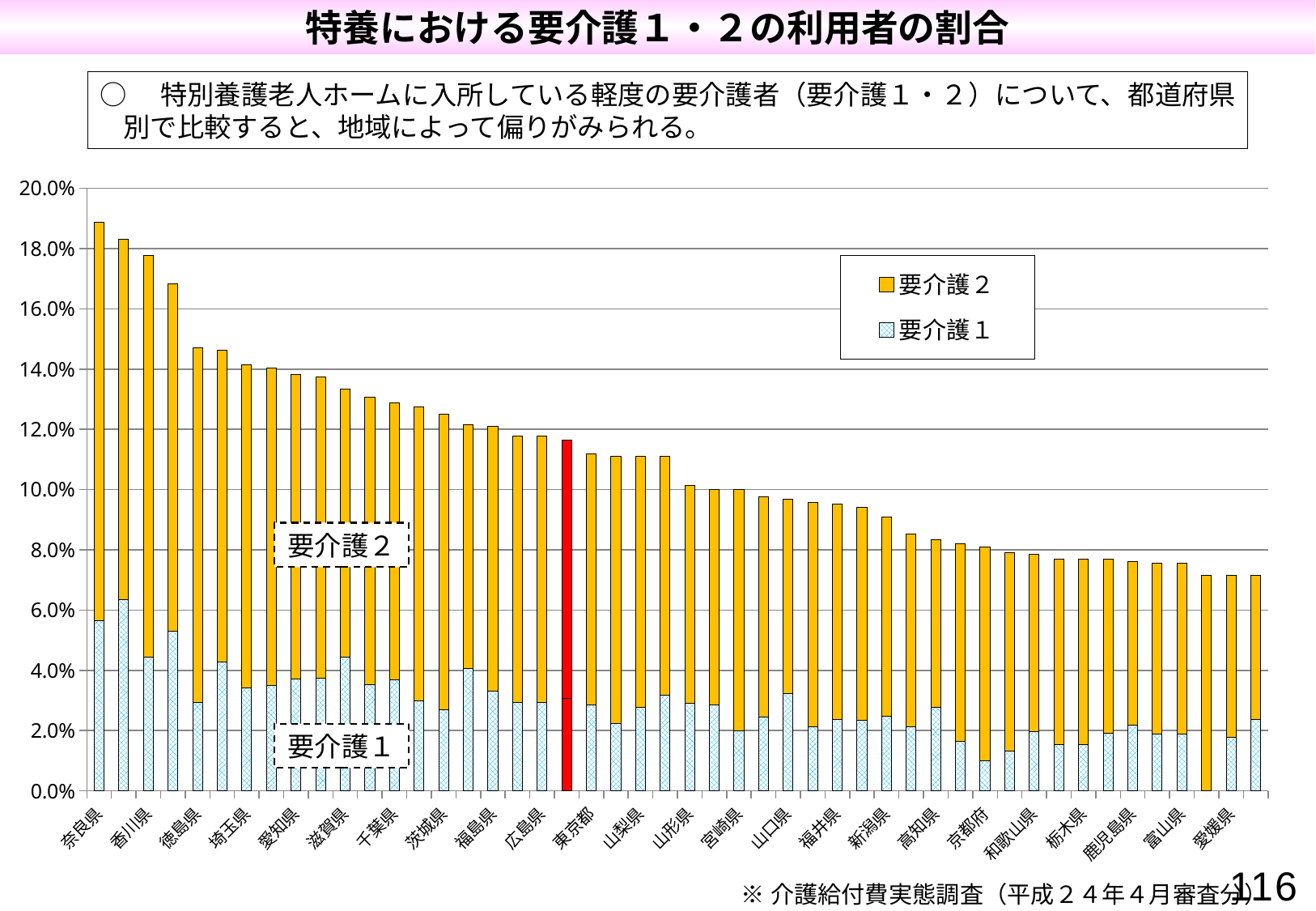
Is the 要介護１ value for 奈良県 greater or less than 4%? greater How many series does the legend list? 2 Is the total value for 徳島県 greater or less than 16%? less Which prefecture has the highest total share of 要介護1・2 users? 奈良県 Is the total value for 奈良県 greater or less than 18%? greater What are the two series named in the legend? 要介護２ and 要介護１ Do the total values rise or fall moving from left to right along the x axis? fall Which has the larger total value, 奈良県 or 東京都? 奈良県 What kind of chart is shown on the slide? Stacked bar chart